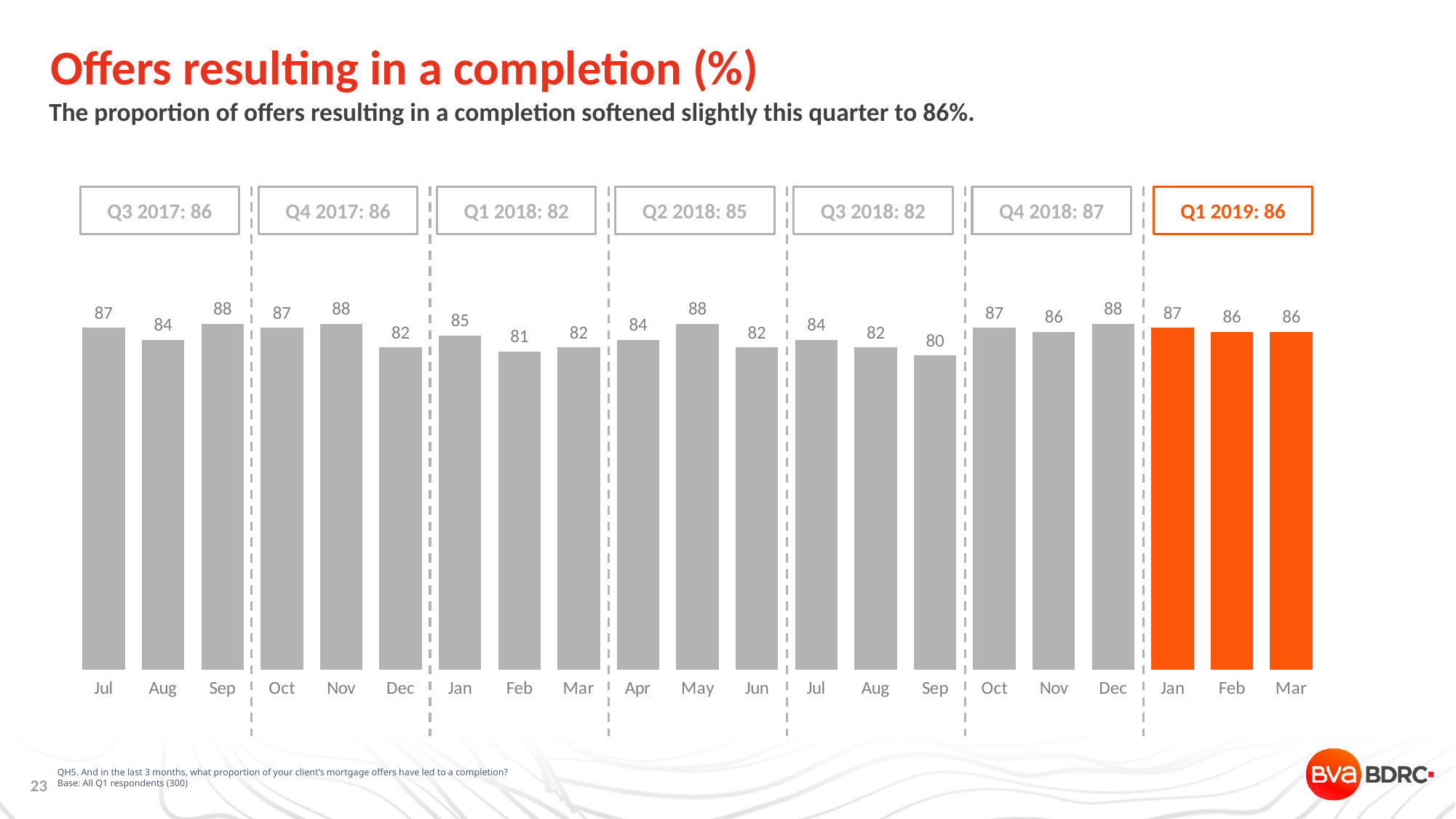
How many monthly bars are plotted on the chart? 21 What is the difference between the values for Nov in Q4 2017 and Dec in Q4 2017? 6 What is the value for Feb in Q1 2018? 81 What type of chart is shown on the slide? Bar chart What is the quarterly figure shown in the box for Q4 2018? 87 What is the value for Dec in Q4 2017? 82 What is the highest value shown on any bar in the chart? 88 Which quarter's bars are highlighted in orange? Q1 2019 Which is larger, the value for Aug in Q3 2017 or the value for Aug in Q3 2018? Aug in Q3 2017 What is the value for Jan in Q1 2019? 87 Which month has the lowest value on the chart? Sep (Q3 2018) What is the value for Sep in Q3 2018? 80